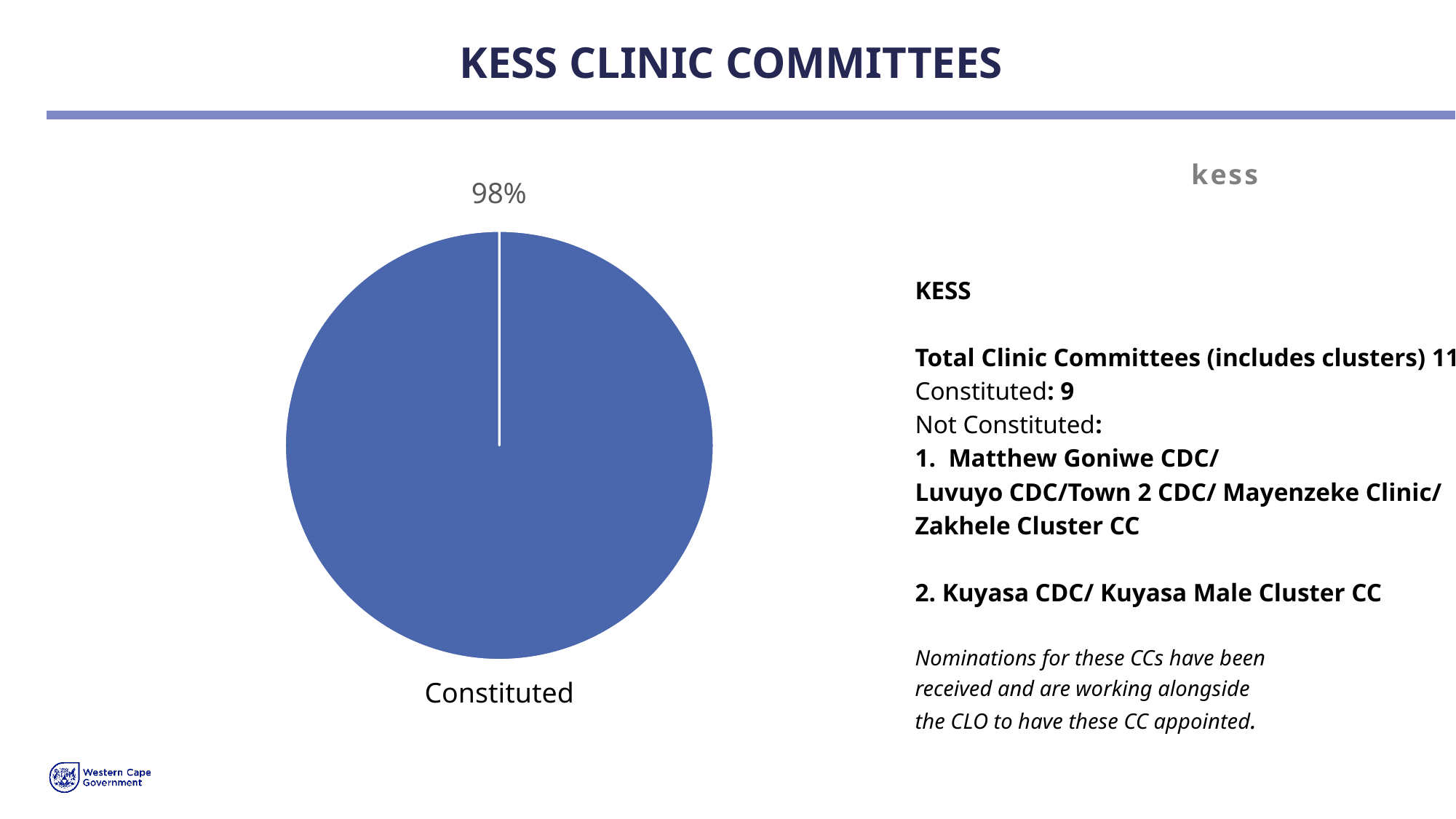
What category label is printed below the pie chart? Constituted How many slices of the pie chart have a readable category label? 1 What colour is the Constituted slice of the pie chart? blue What kind of chart is shown on the slide? pie chart Which slice of the pie chart is the largest? Constituted Is the value for Constituted greater or less than 50%? greater